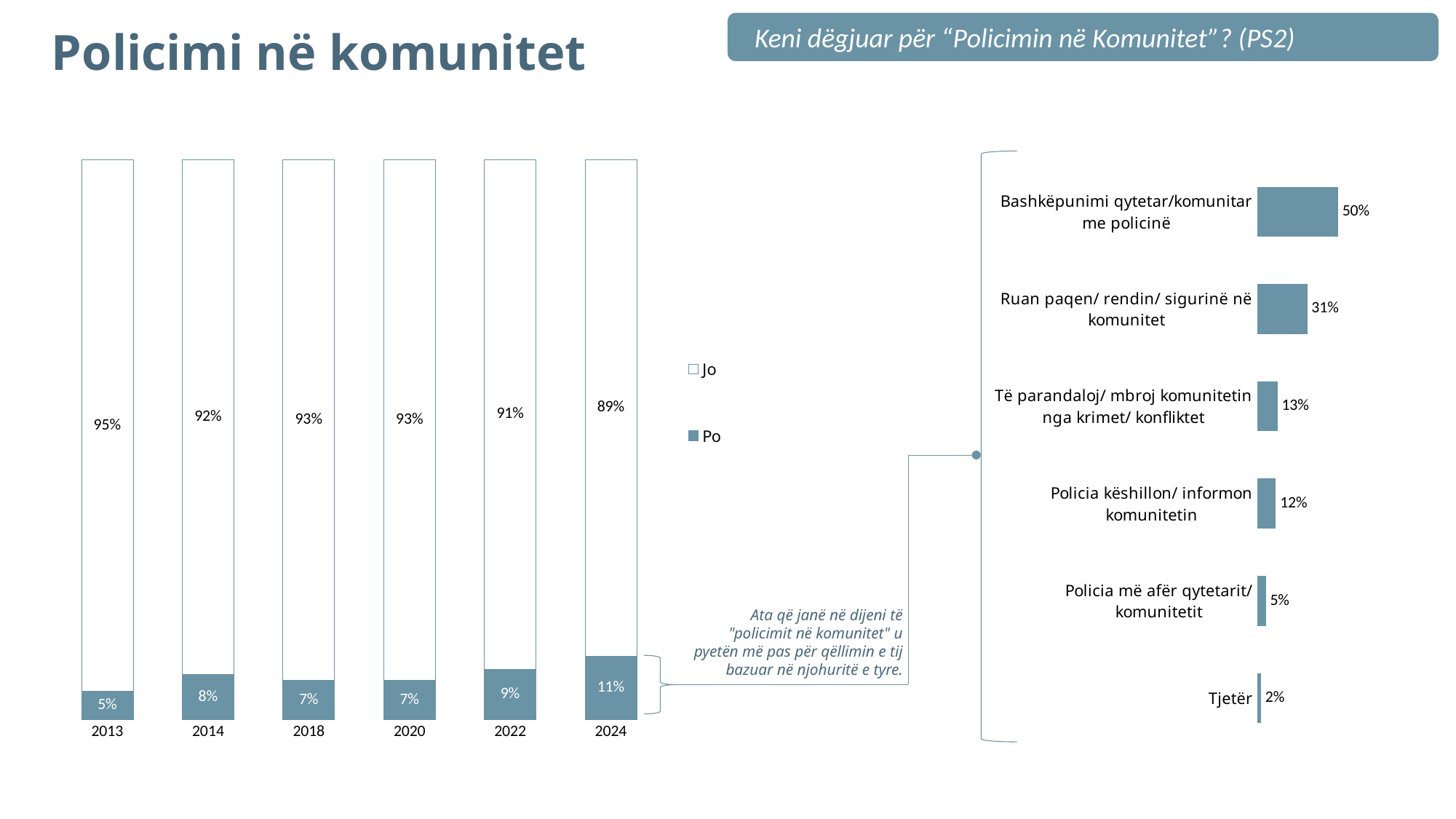
In the stacked bar chart on the left, how many series does the legend list? 2 In the stacked bar chart on the left, which year has the lowest 'Po' value? 2013 In the stacked bar chart on the left, does the 'Po' value generally rise or fall from 2013 to 2024? rise In the horizontal bar chart on the right, which category has the highest value? Bashkëpunimi qytetar/komunitar me policinë In the stacked bar chart on the left, what is the 'Po' value for 2024? 11% In the stacked bar chart on the left, what is the difference between the 'Po' values for 2024 and 2013? 6% In the stacked bar chart on the left, which year has the highest 'Po' value? 2024 In the stacked bar chart on the left, what is the 'Jo' value for 2013? 95% In the horizontal bar chart on the right, what is the value for 'Ruan paqen/ rendin/ sigurinë në komunitet'? 31% What kind of chart is the chart on the right? bar chart In the horizontal bar chart on the right, which is larger: 'Të parandaloj/ mbroj komunitetin nga krimet/ konfliktet' or 'Policia më afër qytetarit/ komunitetit'? Të parandaloj/ mbroj komunitetin nga krimet/ konfliktet In the stacked bar chart on the left, how many years are shown on the x axis? 6